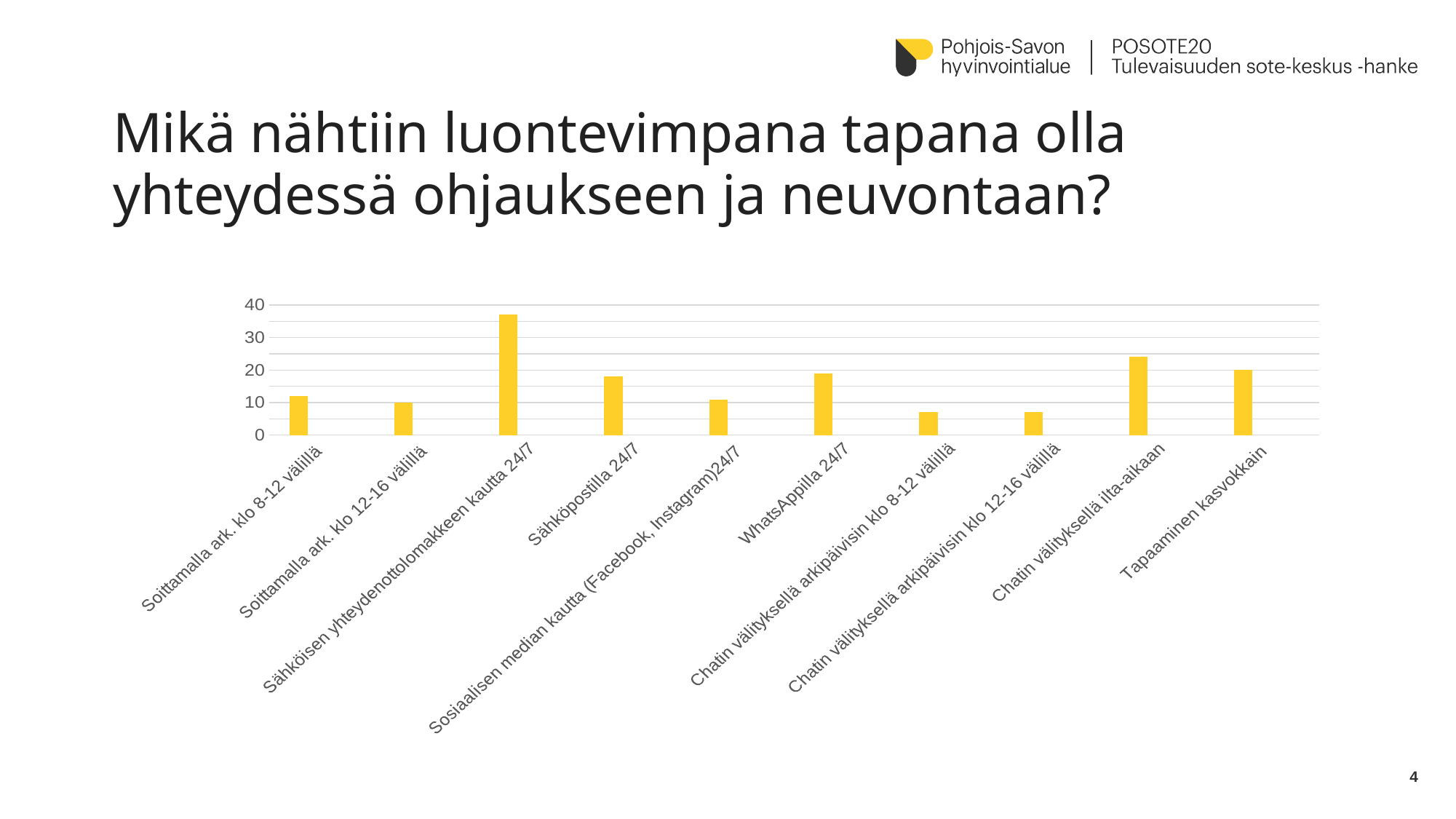
What colour are the bars in the chart? yellow Is the value for Chatin välityksellä arkipäivisin klo 8-12 välillä greater or less than 10? less Is the value for Chatin välityksellä ilta-aikaan greater or less than 20? greater Which is larger, the value for Chatin välityksellä ilta-aikaan or the value for Tapaaminen kasvokkain? Chatin välityksellä ilta-aikaan How many categories are shown on the x axis of the chart? 10 Is the value for Sähköpostilla 24/7 greater or less than 20? less What kind of chart is shown on the slide? bar chart Which category has the highest value in the chart? Sähköisen yhteydenottolomakkeen kautta 24/7 What is the highest value shown on the y axis of the chart? 40 Which is larger, the value for Sähköpostilla 24/7 or the value for Sosiaalisen median kautta (Facebook, Instagram)24/7? Sähköpostilla 24/7